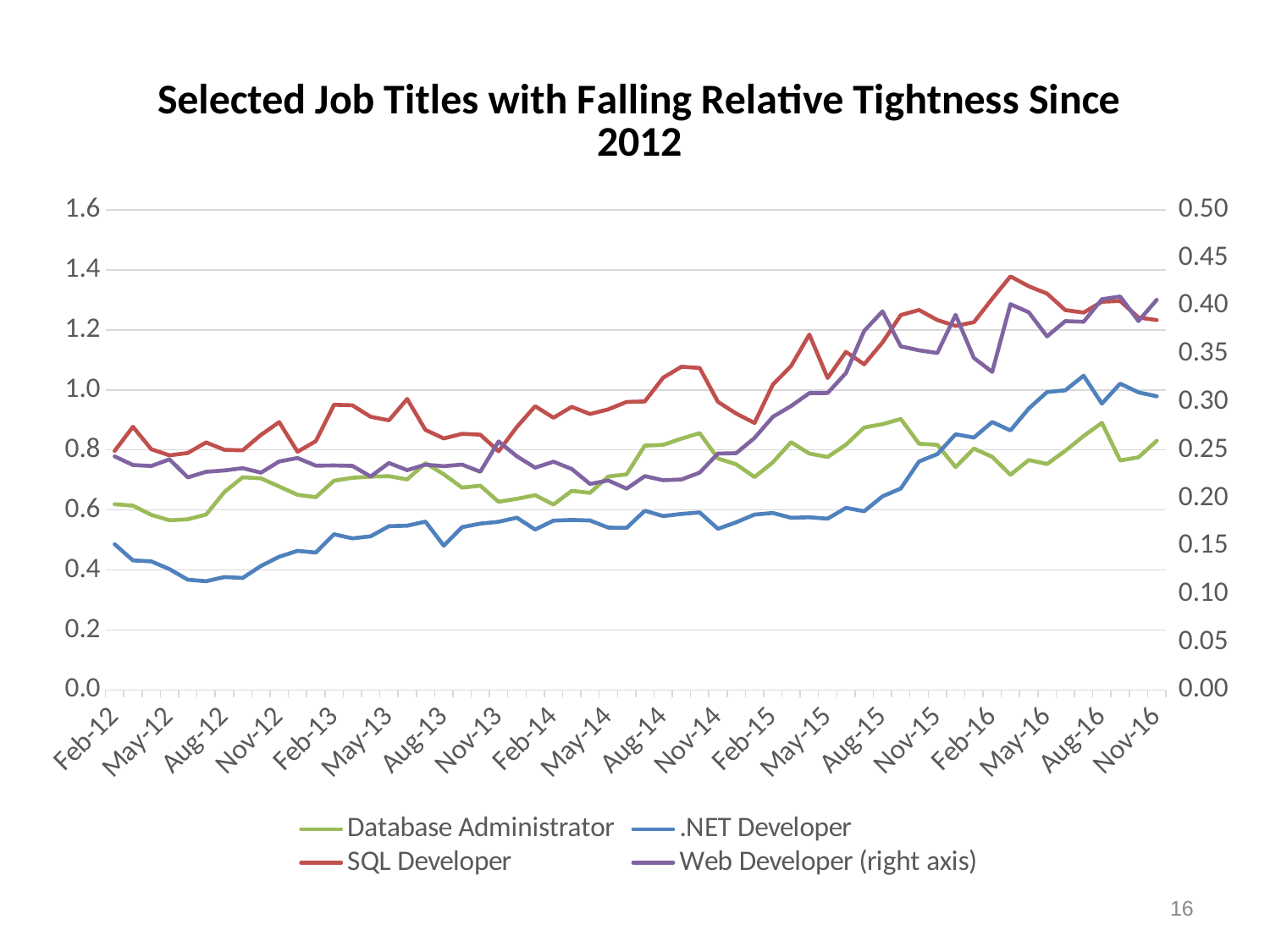
Is the value for SQL Developer at Feb-16 greater or less than 1.0? greater Among the series on the left axis, which has the highest value at Feb-16? SQL Developer What kind of chart is shown on the slide? line chart Does the .NET Developer series generally rise or fall from Feb-12 to Nov-16? rise Which series is plotted against the right axis? Web Developer Is the value for Database Administrator at Feb-12 greater or less than 0.8? less Is the value for Web Developer (right axis) at Aug-15 greater or less than 0.30? greater How many series does the legend list? 4 At Feb-12, which is higher: SQL Developer or .NET Developer? SQL Developer What is the title of the chart? Selected Job Titles with Falling Relative Tightness Since 2012